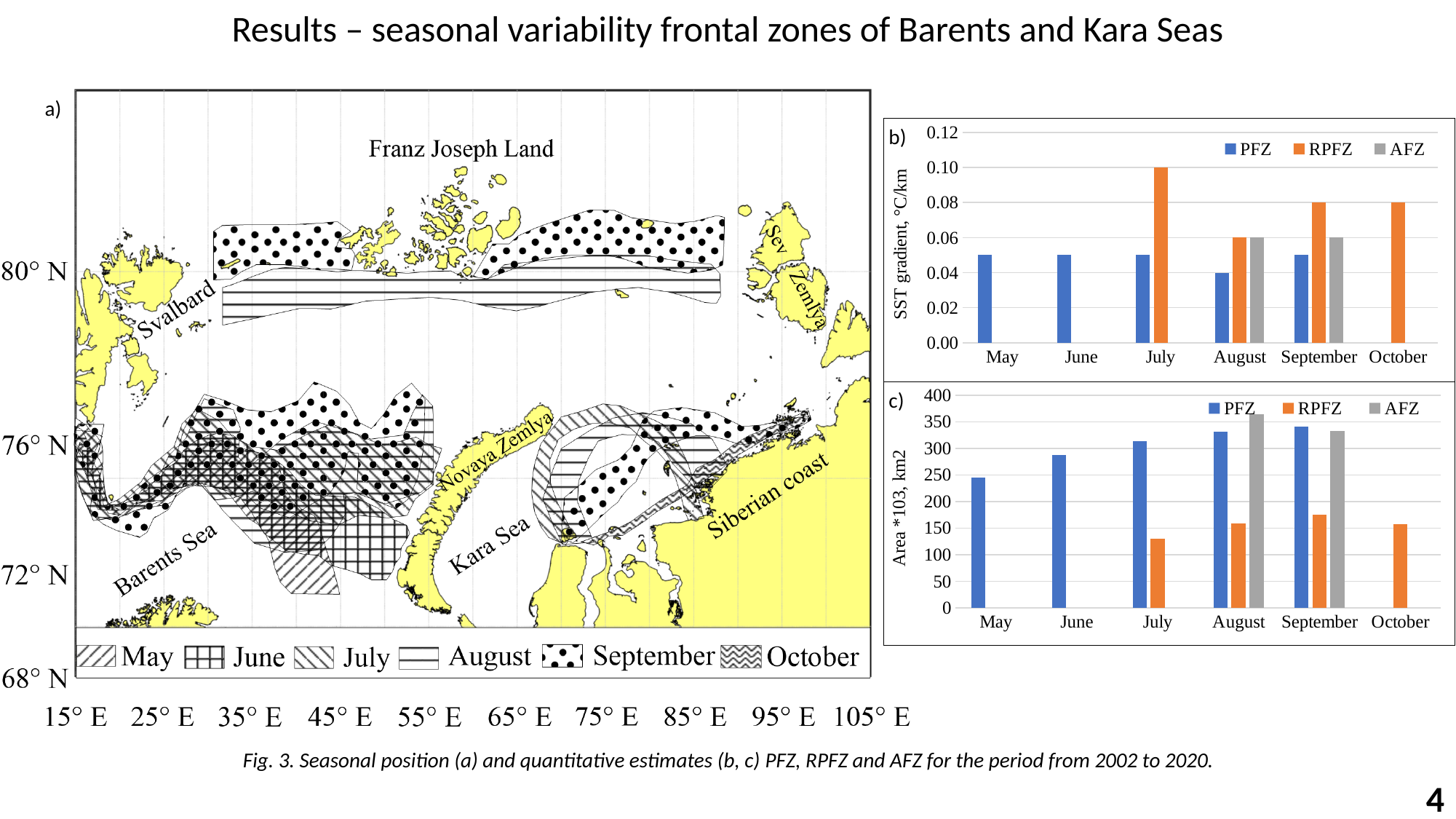
In chart b), what is the SST gradient for RPFZ in July? 0.10 In chart b), how many series does the legend list? 3 In chart c), does the PFZ area rise or fall from May to September? rise In chart b), which series has the highest bar in July? RPFZ In chart c), which series has the highest bar in August? AFZ In chart c), is the area for RPFZ in July greater or less than 150? less What kind of chart is chart c)? bar chart In chart c), which series has the lowest bar in July? RPFZ In chart c), how many months are shown on the x axis? 6 In chart c), is the area for PFZ in June greater or less than 250? greater In chart b), what is the SST gradient for PFZ in August? 0.04 In chart c), is the area for PFZ in July greater or less than 300? greater